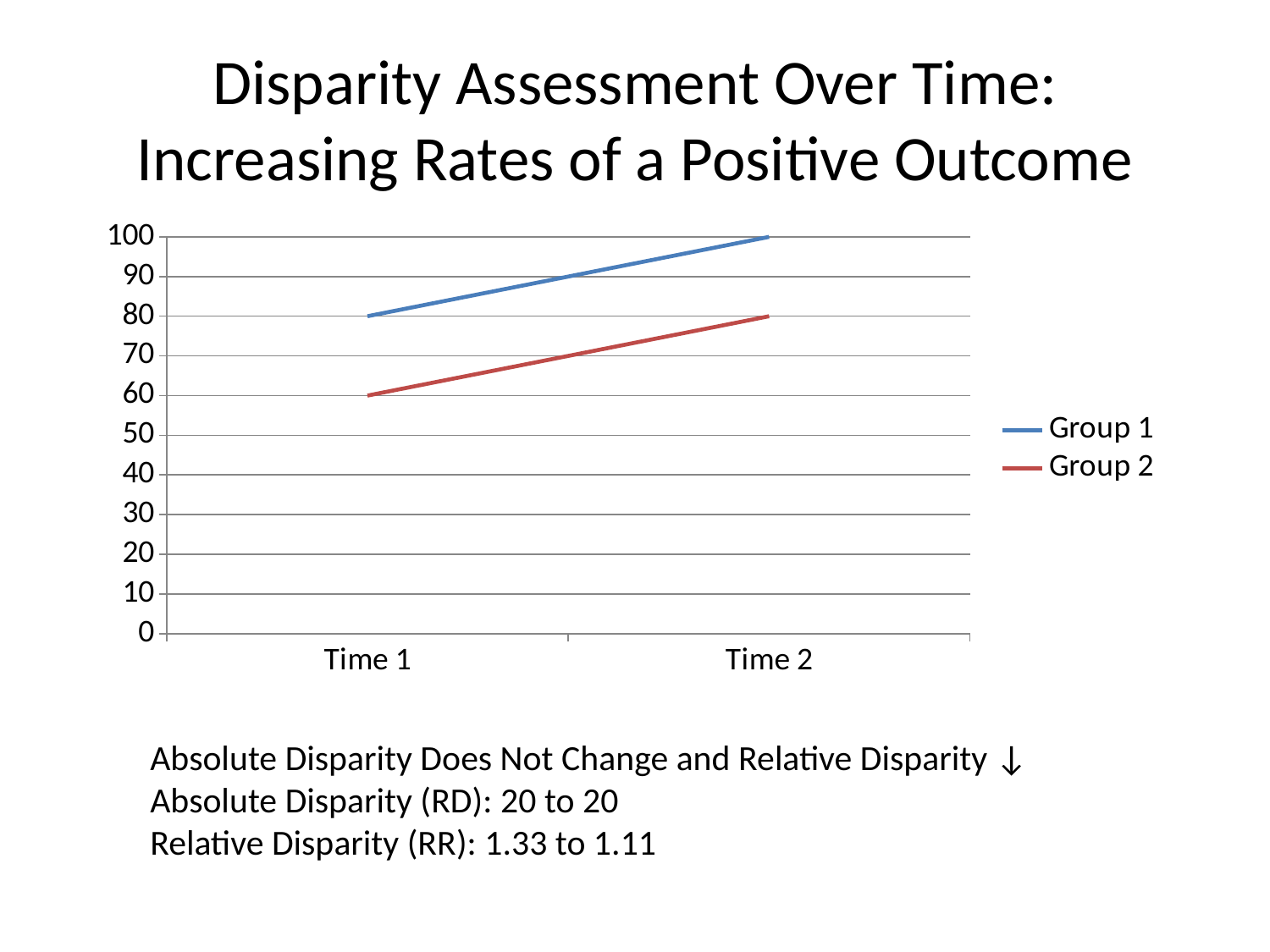
How many time points are shown on the x axis? 2 What is the value for Group 2 at Time 1? 60 Is the value for Group 2 at Time 1 greater or less than 70? less What is the value for Group 1 at Time 1? 80 Do the values for Group 2 rise or fall from Time 1 to Time 2? Rise How many series does the legend list? 2 What kind of chart is shown on the slide? Line chart Which group has the higher value at Time 2? Group 1 What colour is the line for Group 2? Red What is the value for Group 2 at Time 2? 80 What is the difference between Group 1 and Group 2 at Time 1? 20 What is the value for Group 1 at Time 2? 100